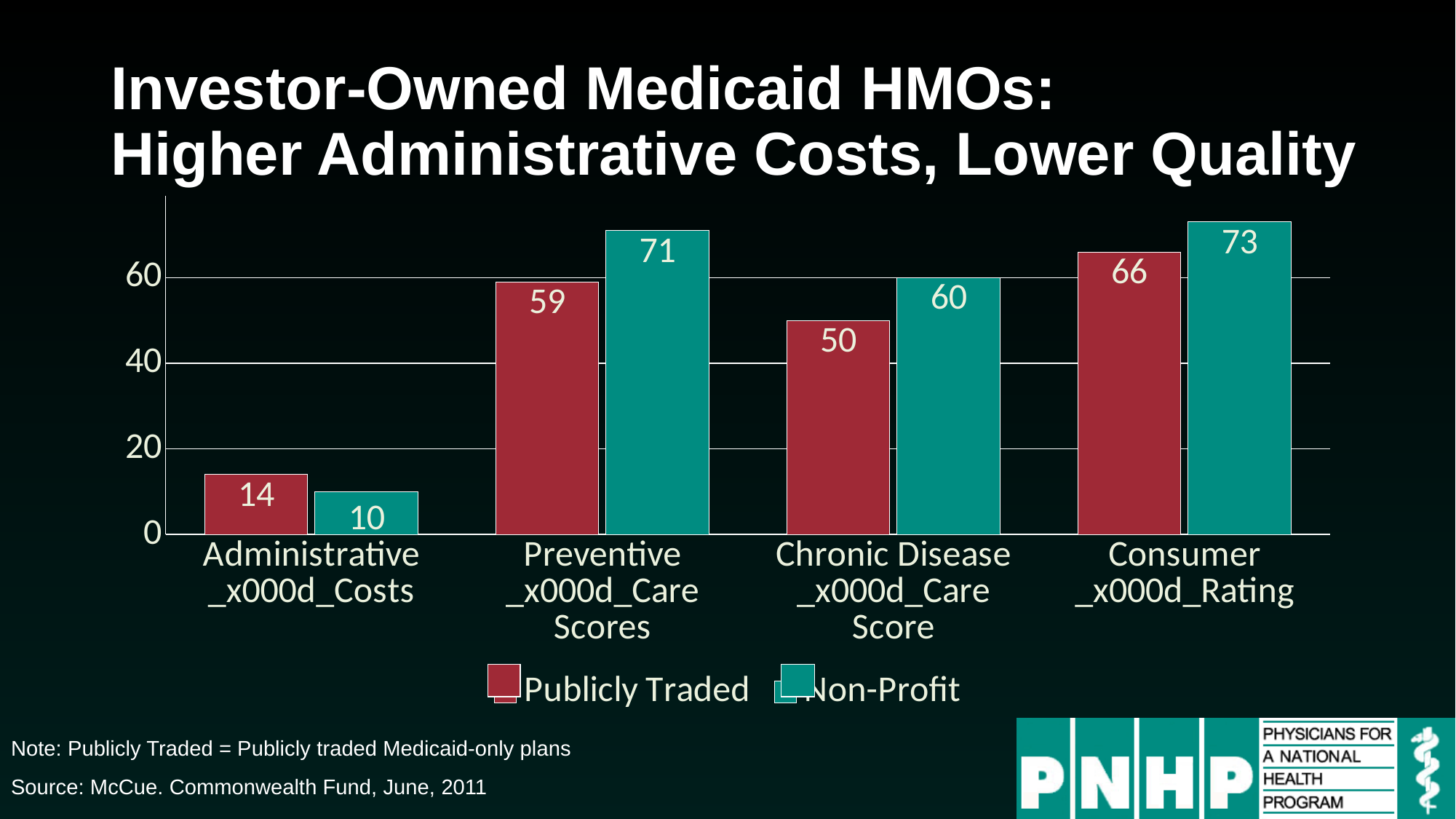
What colour are the Non-Profit bars? Teal What is the Publicly Traded value for Administrative Costs? 14 What is the Non-Profit value for Preventive Care Scores? 71 How many series does the legend list? 2 What is the Publicly Traded value for Chronic Disease Care Score? 50 Which category has the lowest Publicly Traded value? Administrative Costs How many categories are shown on the x axis? 4 What kind of chart is shown on the slide? Bar chart What is the Non-Profit value for Consumer Rating? 73 For Administrative Costs, which is larger: Publicly Traded or Non-Profit? Publicly Traded What is the difference between the Non-Profit and Publicly Traded values for Preventive Care Scores? 12 Which category has the highest Non-Profit value? Consumer Rating